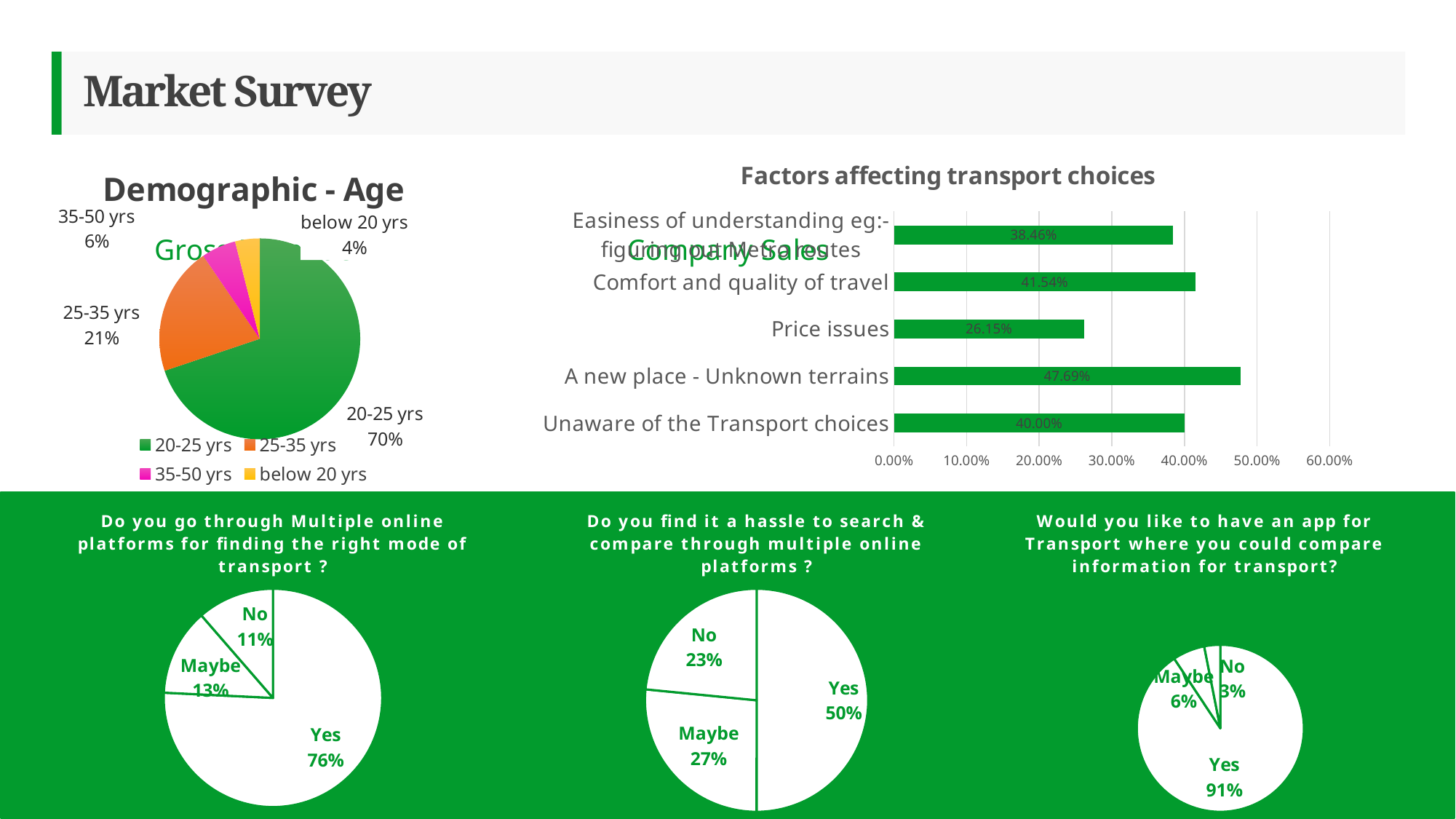
What kind of chart is "Factors affecting transport choices"? bar chart In the "Factors affecting transport choices" chart, what is the difference between Comfort and quality of travel and Price issues? 15.39% In the "Factors affecting transport choices" chart, what is the value for Price issues? 26.15% In the "Factors affecting transport choices" chart, how many factors are listed? 5 In the "Demographic - Age" pie chart, which age group has the smallest slice? below 20 yrs In the pie chart "Do you find it a hassle to search & compare through multiple online platforms ?", what share answered No? 23% In the "Demographic - Age" pie chart, what share is the 20-25 yrs slice? 70% In the "Factors affecting transport choices" chart, which factor has the highest value? A new place - Unknown terrains In the "Demographic - Age" pie chart, how many age groups are shown? 4 In the pie chart "Do you go through Multiple online platforms for finding the right mode of transport ?", what share answered Maybe? 13% In the "Factors affecting transport choices" chart, which is larger: Comfort and quality of travel or Unaware of the Transport choices? Comfort and quality of travel